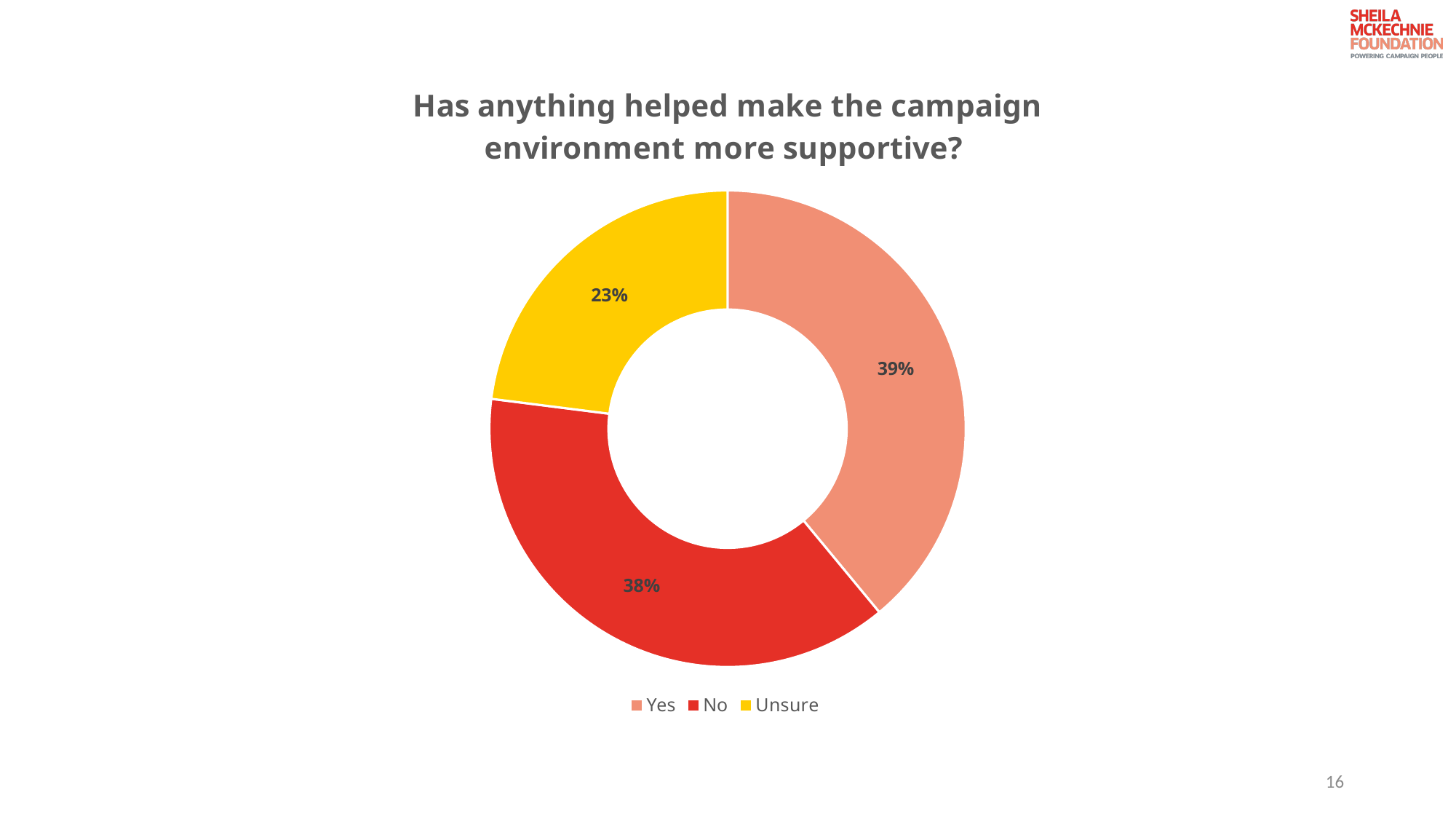
What is the difference in percentage points between the Yes and Unsure shares? 16 Which response has the largest share of the chart? Yes Which is larger, the share for No or the share for Unsure? No What is the title of the chart? Has anything helped make the campaign environment more supportive? What kind of chart is shown on the slide? doughnut chart What percentage of respondents answered Yes? 39% Which response has the smallest share of the chart? Unsure Which colour represents the Unsure response in the legend? yellow What is the difference in percentage points between the No and Unsure shares? 15 How many response categories does the chart show? 3 What percentage of respondents answered Unsure? 23% What percentage of respondents answered No? 38%